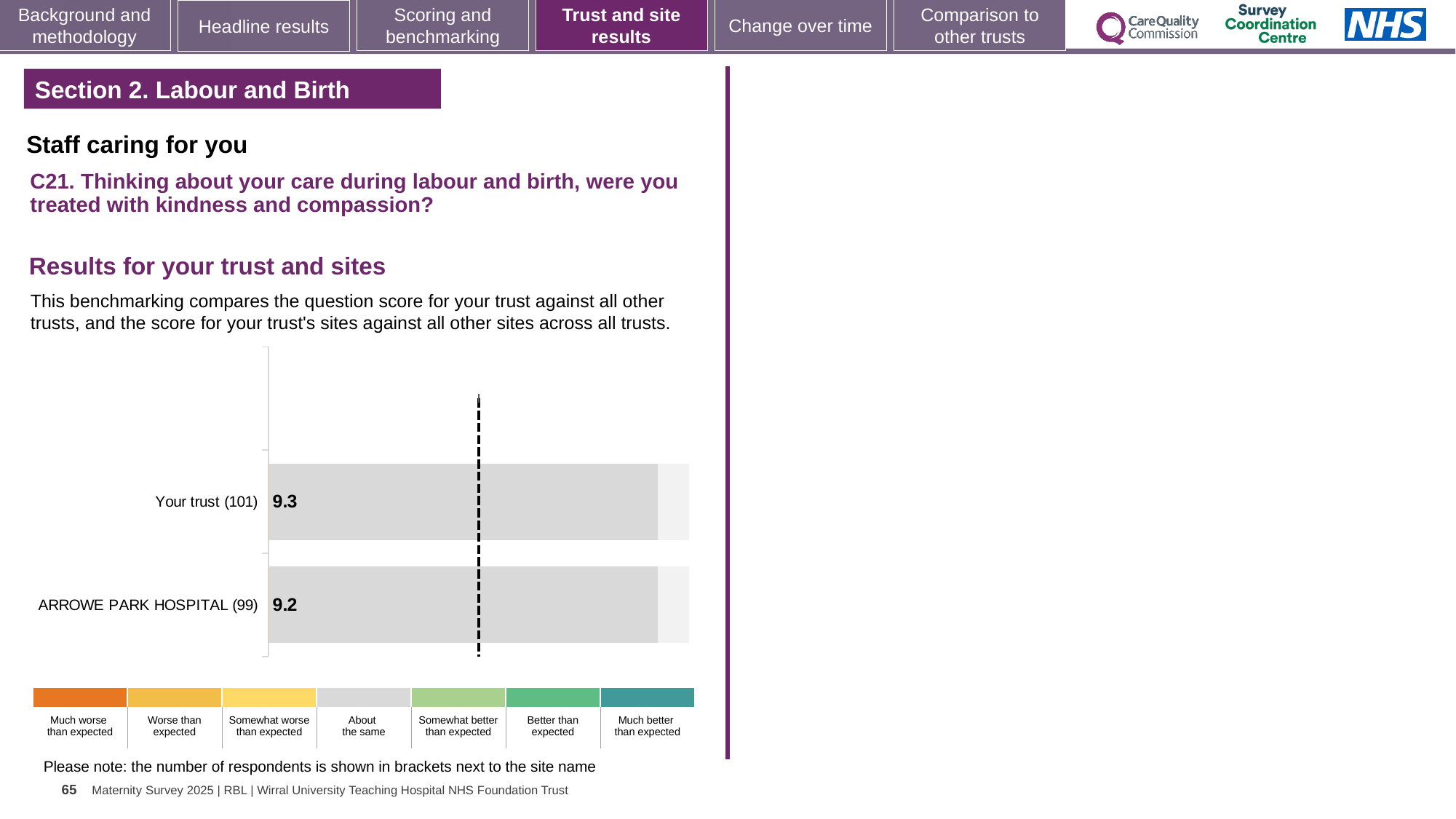
Which category has the lowest score in the chart? ARROWE PARK HOSPITAL (99) Which category has the higher score, Your trust (101) or ARROWE PARK HOSPITAL (99)? Your trust (101) What kind of chart is shown on the slide? Bar chart How many benchmark categories are listed in the colour key below the chart? 7 What is the score shown for Your trust (101)? 9.3 What is the score shown for ARROWE PARK HOSPITAL (99)? 9.2 How many respondents are shown in brackets for Your trust? 101 How many respondents are shown in brackets for ARROWE PARK HOSPITAL? 99 According to the colour key, which benchmark category does the grey colour of the bars represent? About the same How many bars are plotted in the chart? 2 What is the difference between the score for Your trust (101) and the score for ARROWE PARK HOSPITAL (99)? 0.1